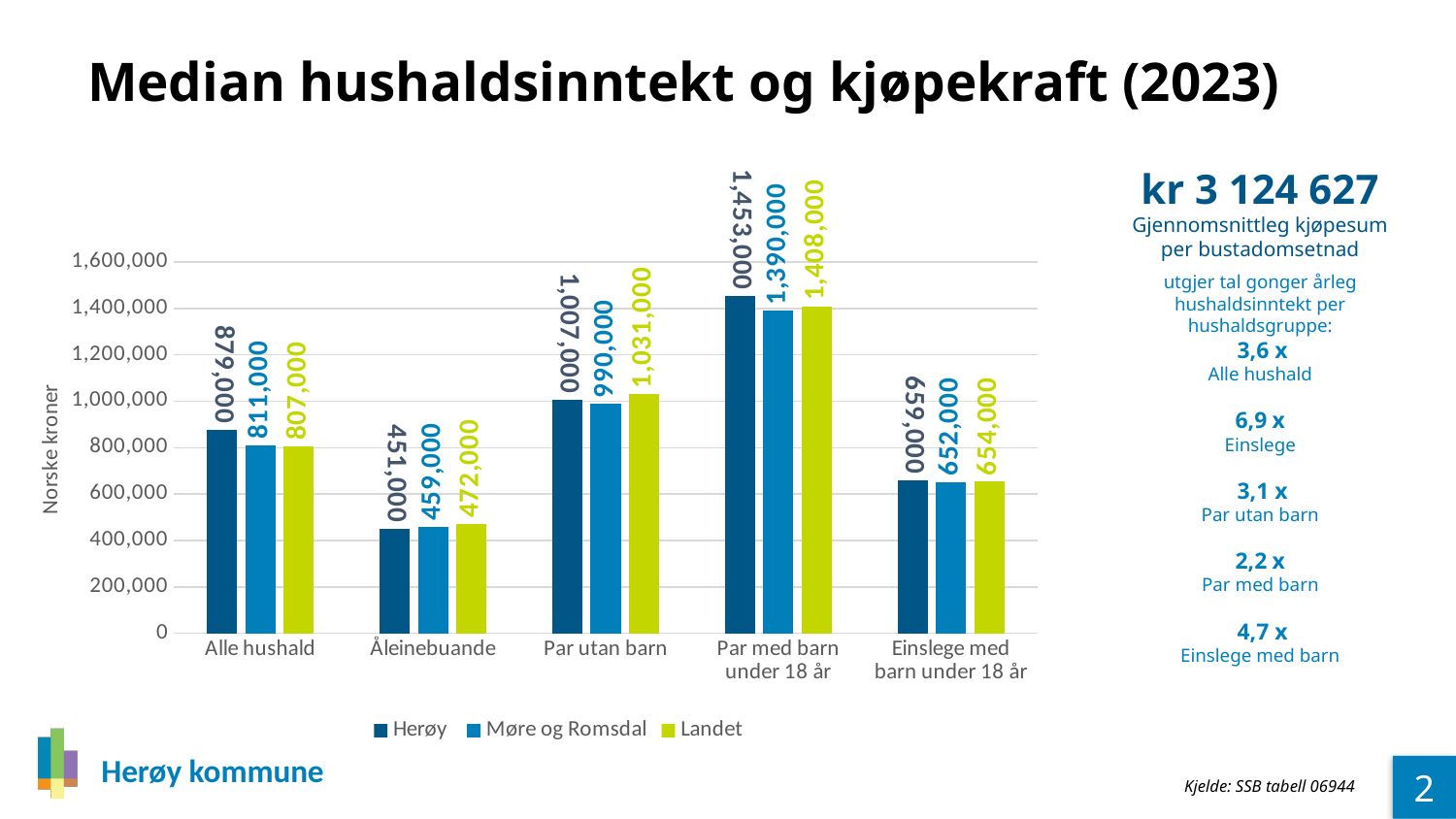
What is the difference between the Herøy and Møre og Romsdal values in the 'Alle hushald' category? 68,000 In the 'Åleinebuande' category, which is larger: Herøy or Landet? Landet What is the median household income for Herøy in the 'Alle hushald' category? 879,000 What kind of chart is shown on the slide? Bar chart What is the label of the y axis? Norske kroner Which category has the lowest value for Landet? Åleinebuande How many categories are shown on the x axis? 5 What is the value for Møre og Romsdal in the 'Par med barn under 18 år' category? 1,390,000 What is the value for Herøy in the 'Åleinebuande' category? 451,000 How many series does the legend list? 3 Which category has the highest value for Herøy? Par med barn under 18 år What is the value for Landet in the 'Par utan barn' category? 1,031,000